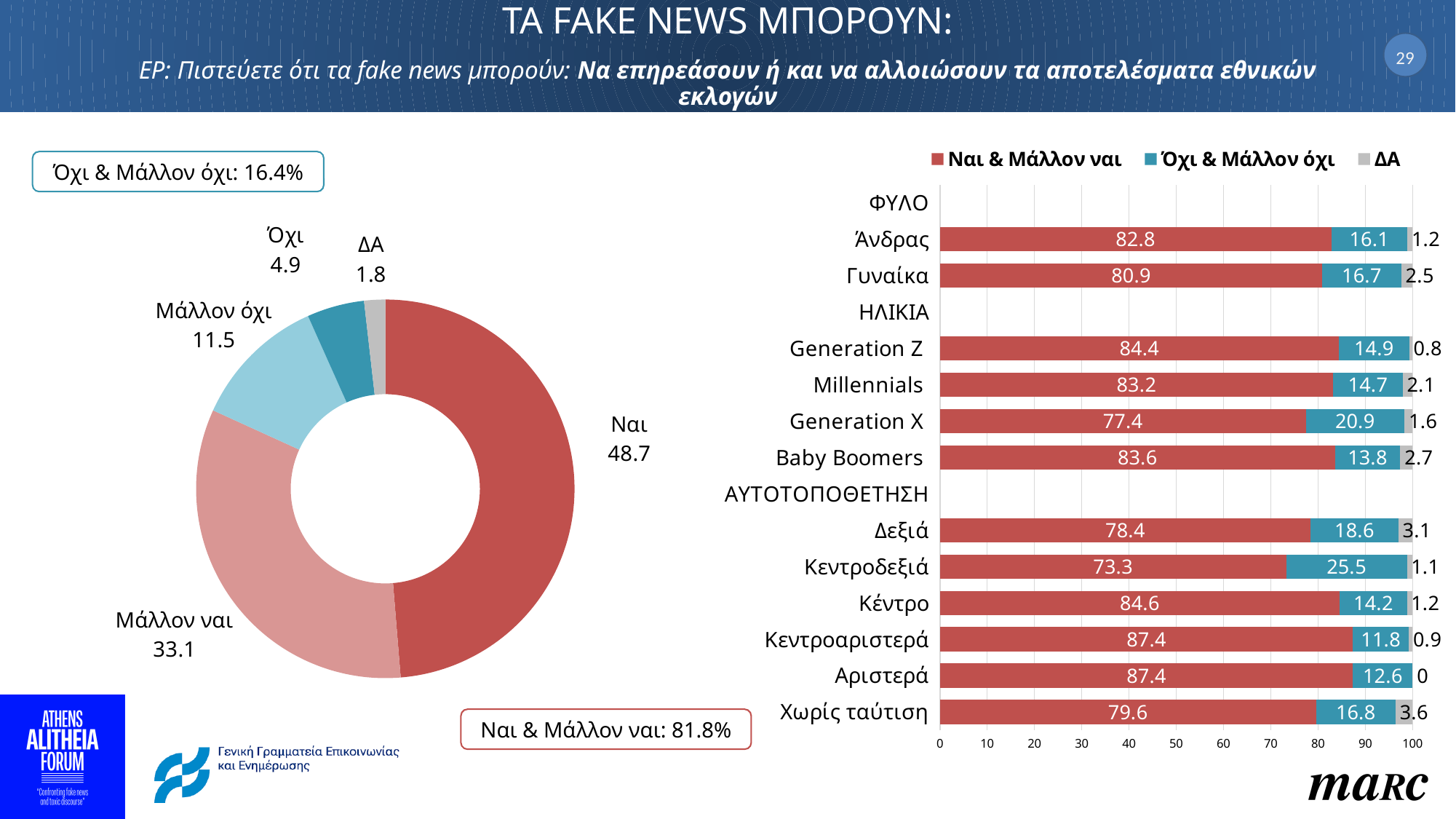
In the bar chart on the right, what is the difference between the Ναι & Μάλλον ναι values for Άνδρας and Γυναίκα? 1.9 In the donut chart on the left, what is the value for Ναι? 48.7 In the bar chart on the right, what is the Όχι & Μάλλον όχι value for Generation X? 20.9 In the donut chart on the left, which category has the smallest slice? ΔΑ In the donut chart on the left, how many slices are there? 5 In the bar chart on the right, what is the ΔΑ value for Αριστερά? 0 What kind of chart is the chart on the left? Pie (donut) chart What kind of chart is the chart on the right? Bar chart How many series does the legend of the bar chart on the right list? 3 In the donut chart on the left, which category has the largest slice? Ναι In the bar chart on the right, what is the Ναι & Μάλλον ναι value for Κεντροδεξιά? 73.3 In the bar chart on the right, which category has the highest Όχι & Μάλλον όχι value? Κεντροδεξιά